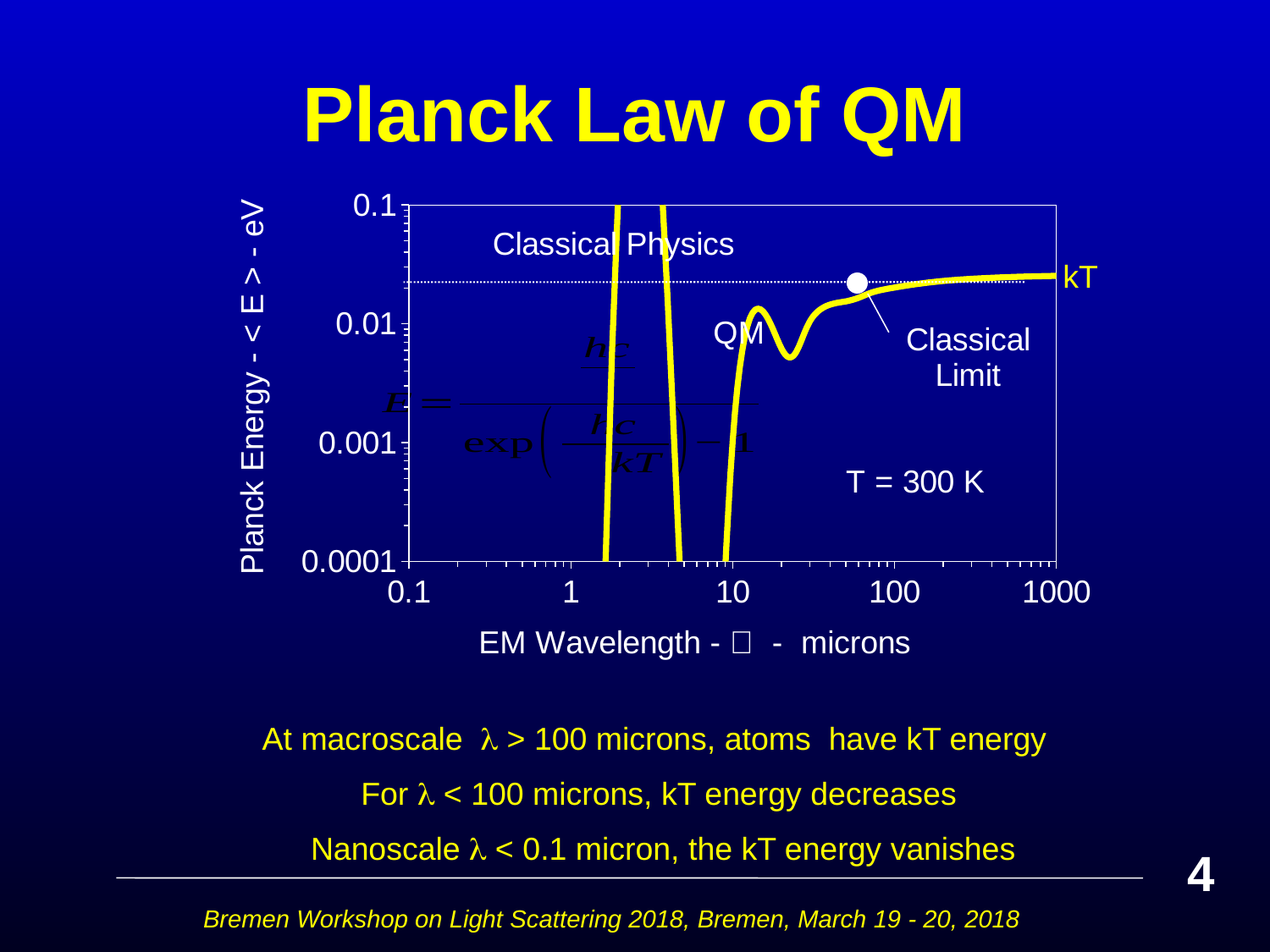
As the wavelength increases from 10 to 1000 microns, does the Planck energy curve overall rise or fall? rise What label is given to the dotted horizontal line on the chart? kT What is the title of the slide containing the chart? Planck Law of QM Is the Planck energy at 1000 microns greater or less than 0.01 eV? greater Which label appears on the curve near 10 microns, below the kT line? QM Is the Planck energy at 100 microns greater or less than 0.01 eV? greater What is the largest wavelength tick shown on the horizontal axis? 1000 What temperature is annotated on the chart? T = 300 K What label is attached to the white dot on the curve? Classical Limit What kind of chart is shown on the slide? line chart What is the label on the vertical axis of the chart? Planck Energy - < E > - eV Which region label appears above the kT line on the chart? Classical Physics